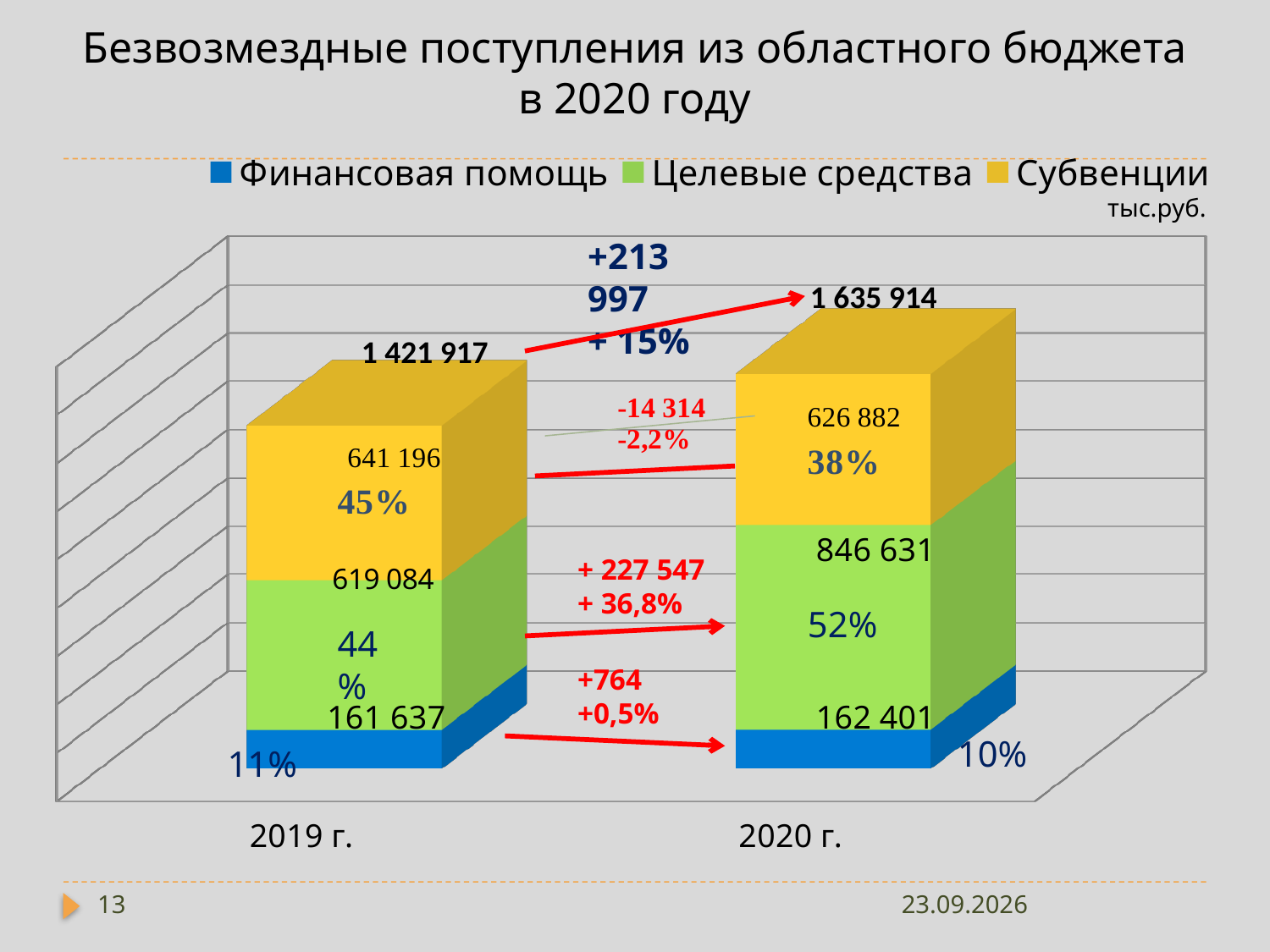
What is the value of Целевые средства for 2020 г.? 846 631 Which is larger: Субвенции in 2019 г. or Субвенции in 2020 г.? 2019 г. What is the difference between Целевые средства in 2020 г. and in 2019 г.? 227 547 What is the total of the stacked bar for 2019 г.? 1 421 917 What is the value of Субвенции for 2019 г.? 641 196 What is the value of Финансовая помощь for 2020 г.? 162 401 What share of the 2020 г. total do Субвенции make up, as labelled on the chart? 38% What type of chart is shown on the slide? stacked bar chart How many series does the legend list? 3 How many categories (years) are shown on the x axis? 2 What is the total of the stacked bar for 2020 г.? 1 635 914 Which series has the smallest value in 2020 г.? Финансовая помощь